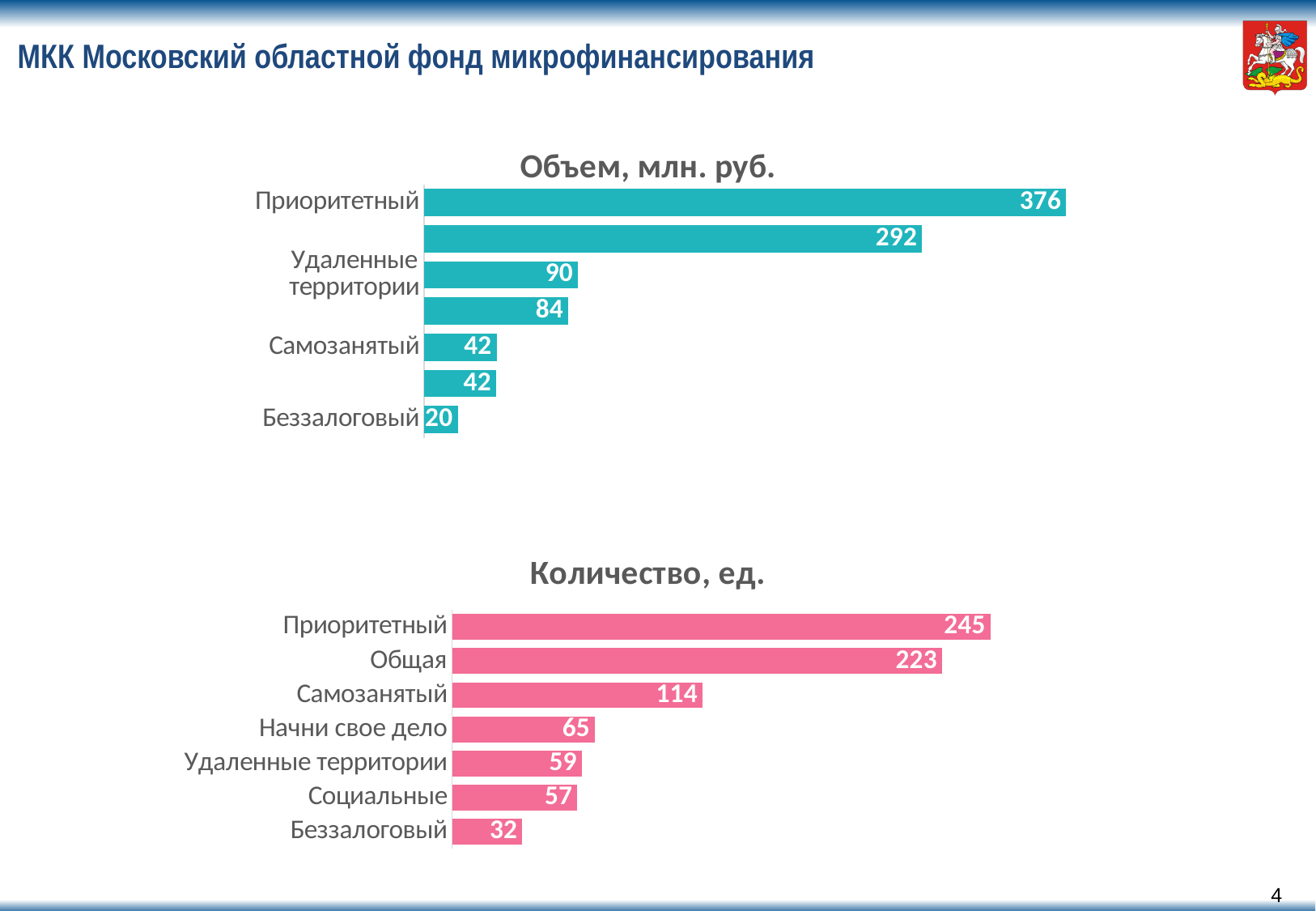
In the chart titled "Количество, ед.", which category has the highest value? Приоритетный In the chart titled "Объем, млн. руб.", what is the value for Приоритетный? 376 In the chart titled "Объем, млн. руб.", what is the difference between the values for Приоритетный and Беззалоговый? 356 In the chart titled "Объем, млн. руб.", what is the value for Удаленные территории? 90 In the chart titled "Количество, ед.", how many categories are shown? 7 In the chart titled "Количество, ед.", which is larger, Начни свое дело or Удаленные территории? Начни свое дело In the chart titled "Количество, ед.", what is the difference between the values for Приоритетный and Общая? 22 In the chart titled "Количество, ед.", what is the value for Самозанятый? 114 In the chart titled "Объем, млн. руб.", which category has the lowest value? Беззалоговый In the chart titled "Объем, млн. руб.", how many bars are plotted? 7 What type of chart is the chart titled "Количество, ед."? Bar chart In the chart titled "Количество, ед.", what is the value for Социальные? 57